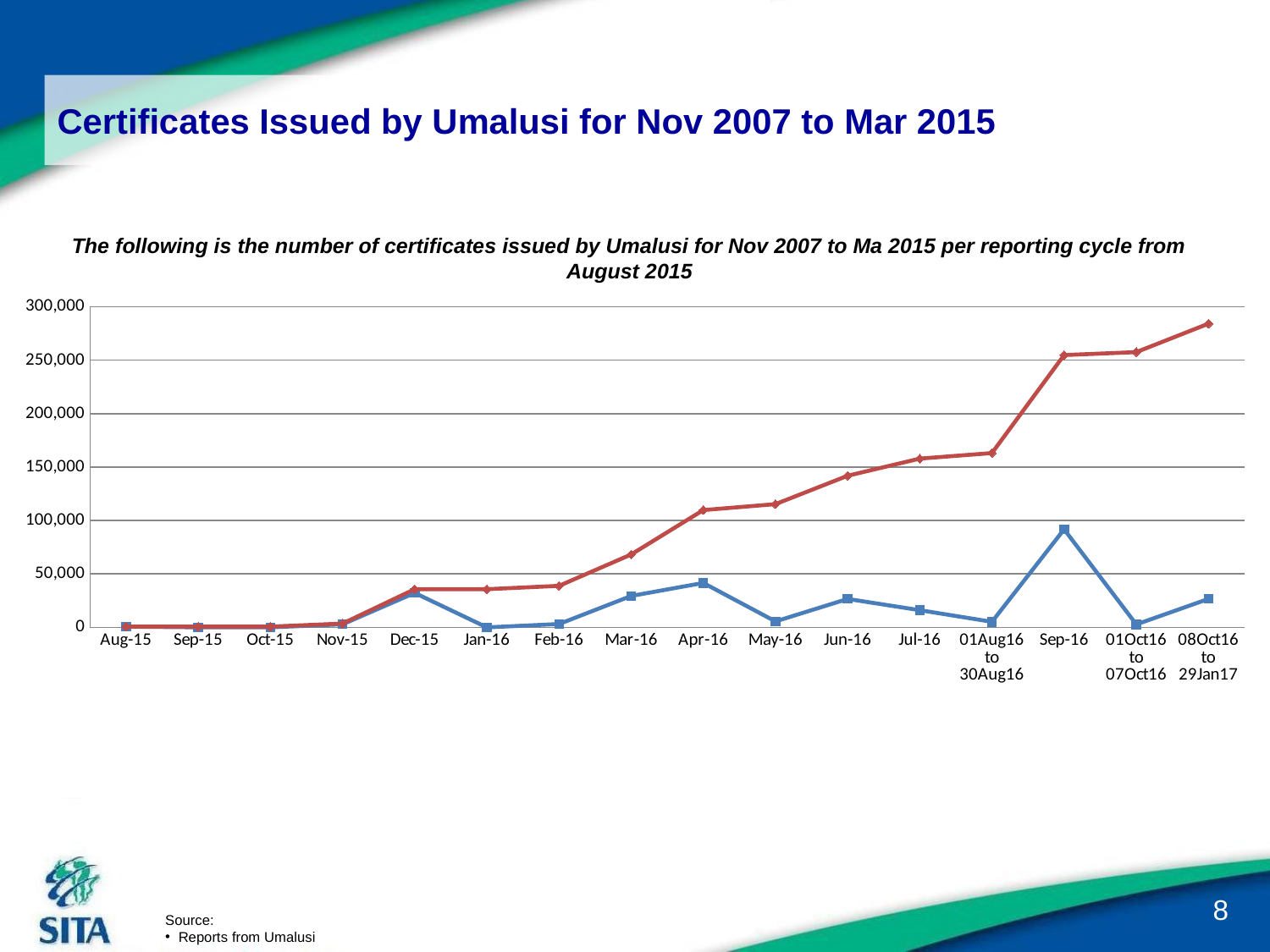
Is the value of the blue line for Apr-16 greater or less than 50,000? less Is the value of the blue line for Sep-16 greater or less than 50,000? greater For the blue line, which is larger: the value for Sep-16 or the value for Apr-16? Sep-16 How many reporting periods are shown along the x axis of the chart? 16 At Sep-16, which line has the larger value, the red line or the blue line? Red line What kind of chart is shown on the slide? Line chart Is the value of the red line for Jul-16 greater or less than 150,000? greater At which reporting period does the blue line reach its highest value? Sep-16 Does the red line generally rise or fall from Aug-15 to 08Oct16 to 29Jan17? Rise At which reporting period does the red line reach its highest value? 08Oct16 to 29Jan17